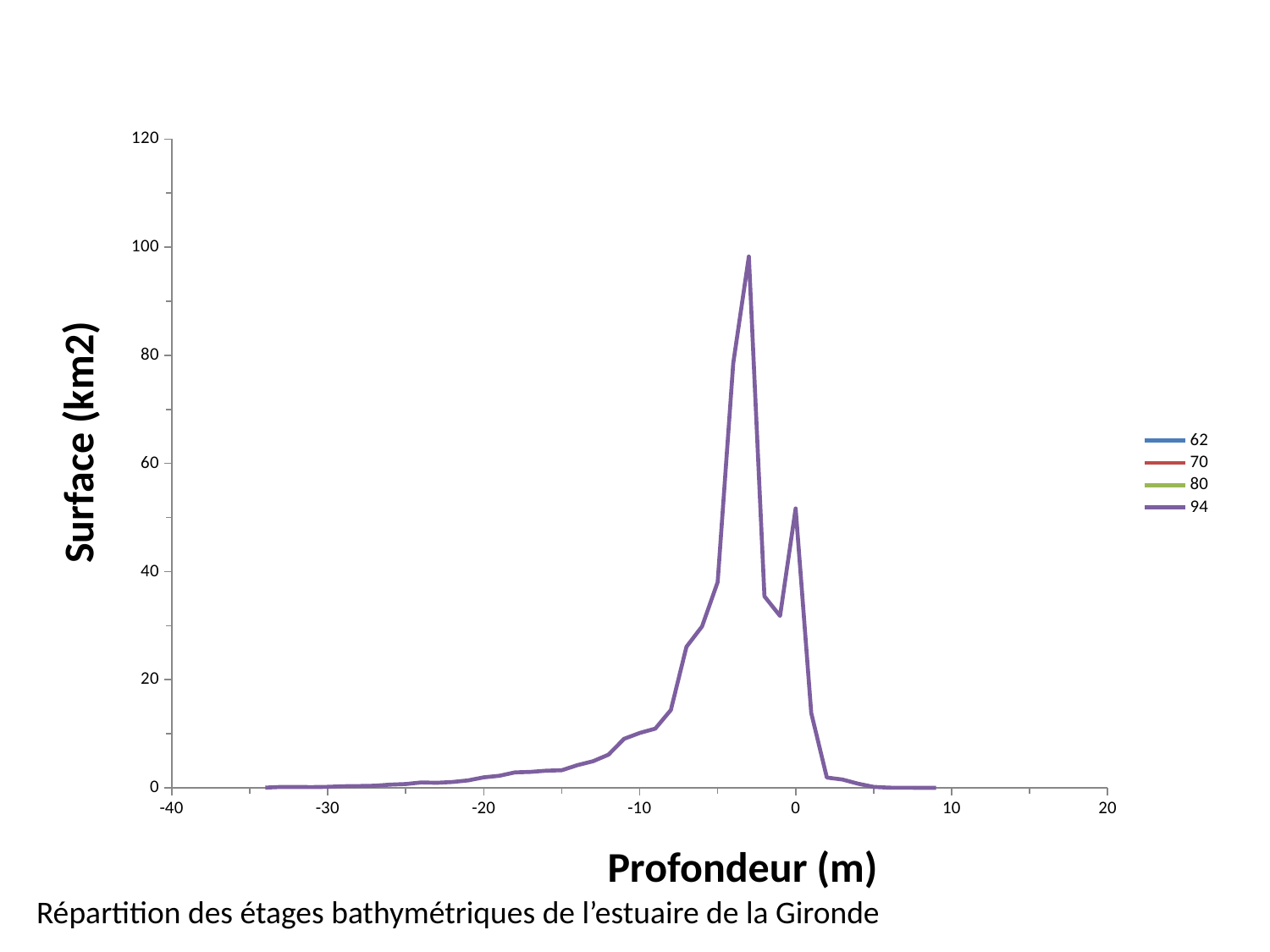
Does the line rise or fall as the depth goes from 0 m to 5 m? fall What is the title of the vertical axis? Surface (km2) Is the value of the line at a depth of -20 m greater or less than 20? less Is the value of the line at a depth of 0 m greater or less than 40? greater Does the line rise or fall as the depth goes from -30 m to -5 m? rise How many series does the legend list? 4 Is the value of the line at a depth of 5 m greater or less than 20? less What are the entries listed in the legend? 62, 70, 80, 94 What kind of chart is shown on the slide? line chart